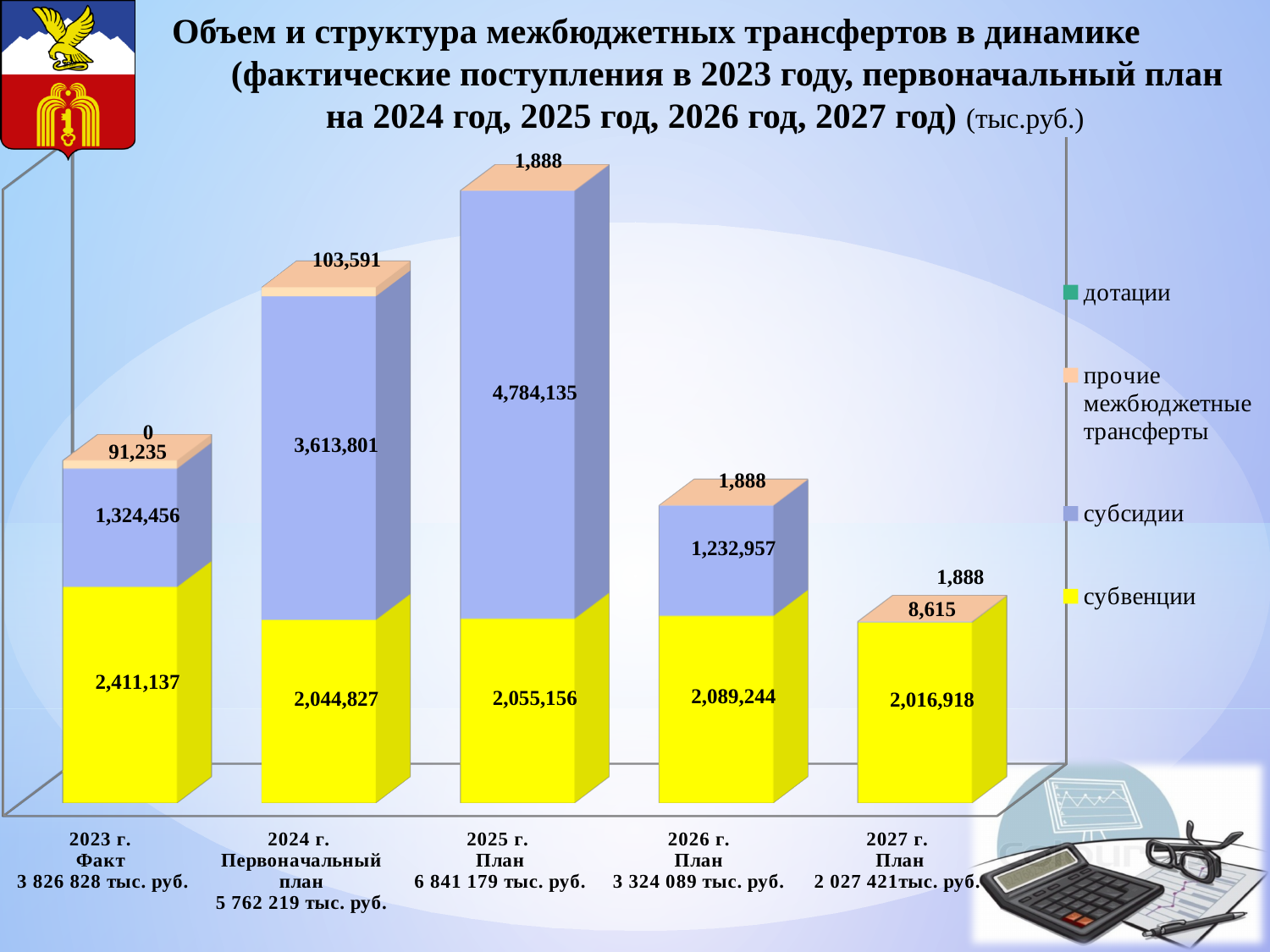
What is the value of субсидии for 2025 г. План? 4,784,135 What is the total for the 2026 г. План bar? 3 324 089 тыс. руб. What kind of chart is shown on the slide? stacked bar chart What is the value of субвенции for 2023 г. Факт? 2,411,137 What is the difference between субсидии in 2024 г. and субсидии in 2026 г.? 2,380,844 Which year has the highest total of межбюджетные трансферты? 2025 г. How many year categories are shown along the x axis? 5 What is the value of прочие межбюджетные трансферты for 2024 г.? 103,591 How many series does the legend list? 4 What is the value of субсидии for 2027 г. План? 8,615 Which is larger: субвенции in 2023 г. or субвенции in 2027 г.? субвенции in 2023 г. Which year has the lowest total of межбюджетные трансферты? 2027 г.